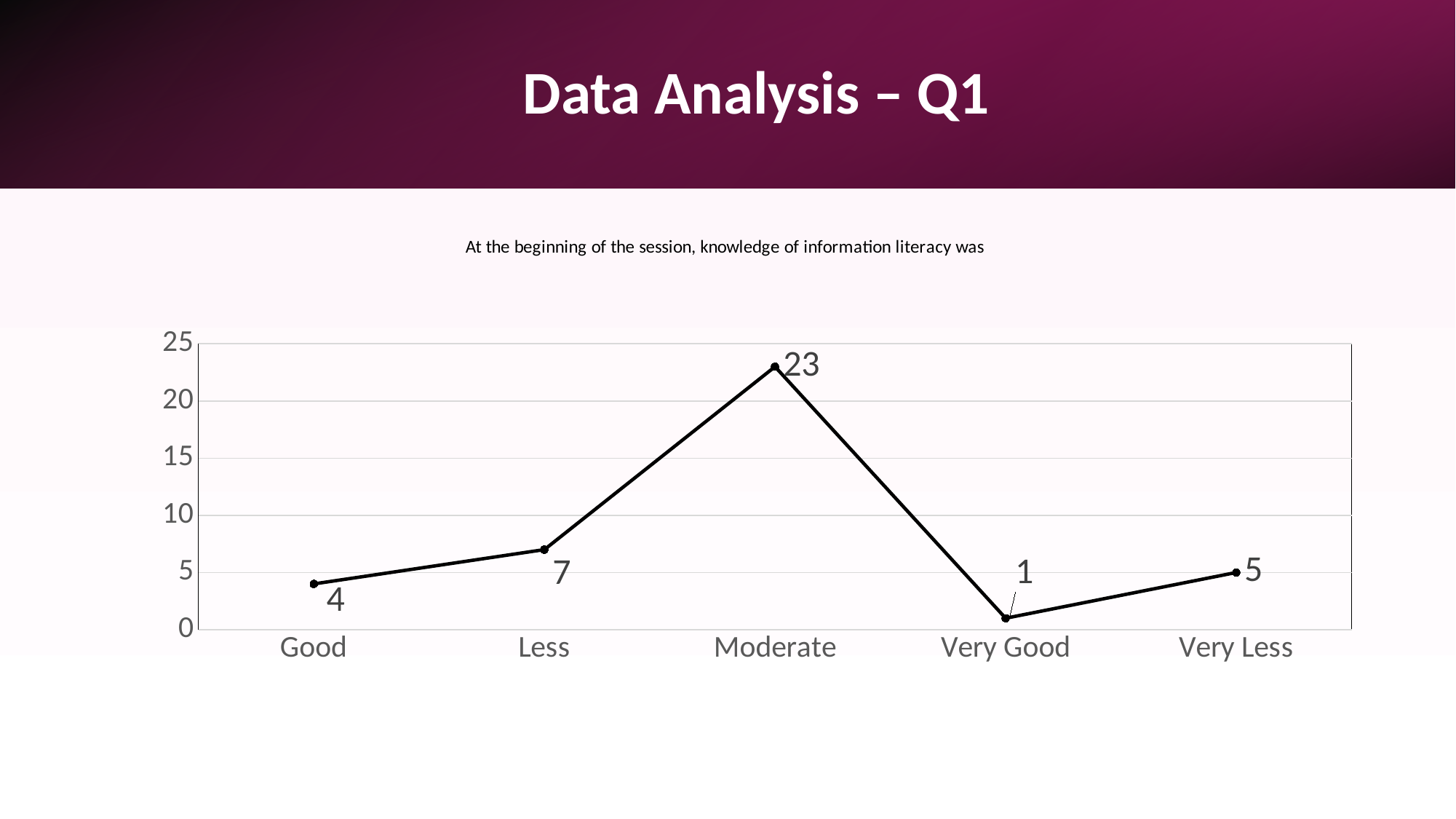
Which is larger, the value for Less or the value for Very Less? Less What is the value for Good? 4 Which category has the highest value? Moderate What kind of chart is shown on the slide? line chart What is the value for Very Good? 1 Which category has the lowest value? Very Good What is the value for Moderate? 23 What is the value for Very Less? 5 What is the difference between the values for Moderate and Less? 16 Is the value for Moderate greater or less than 20? greater What is the title of the chart? At the beginning of the session, knowledge of information literacy was How many categories are shown on the x axis? 5